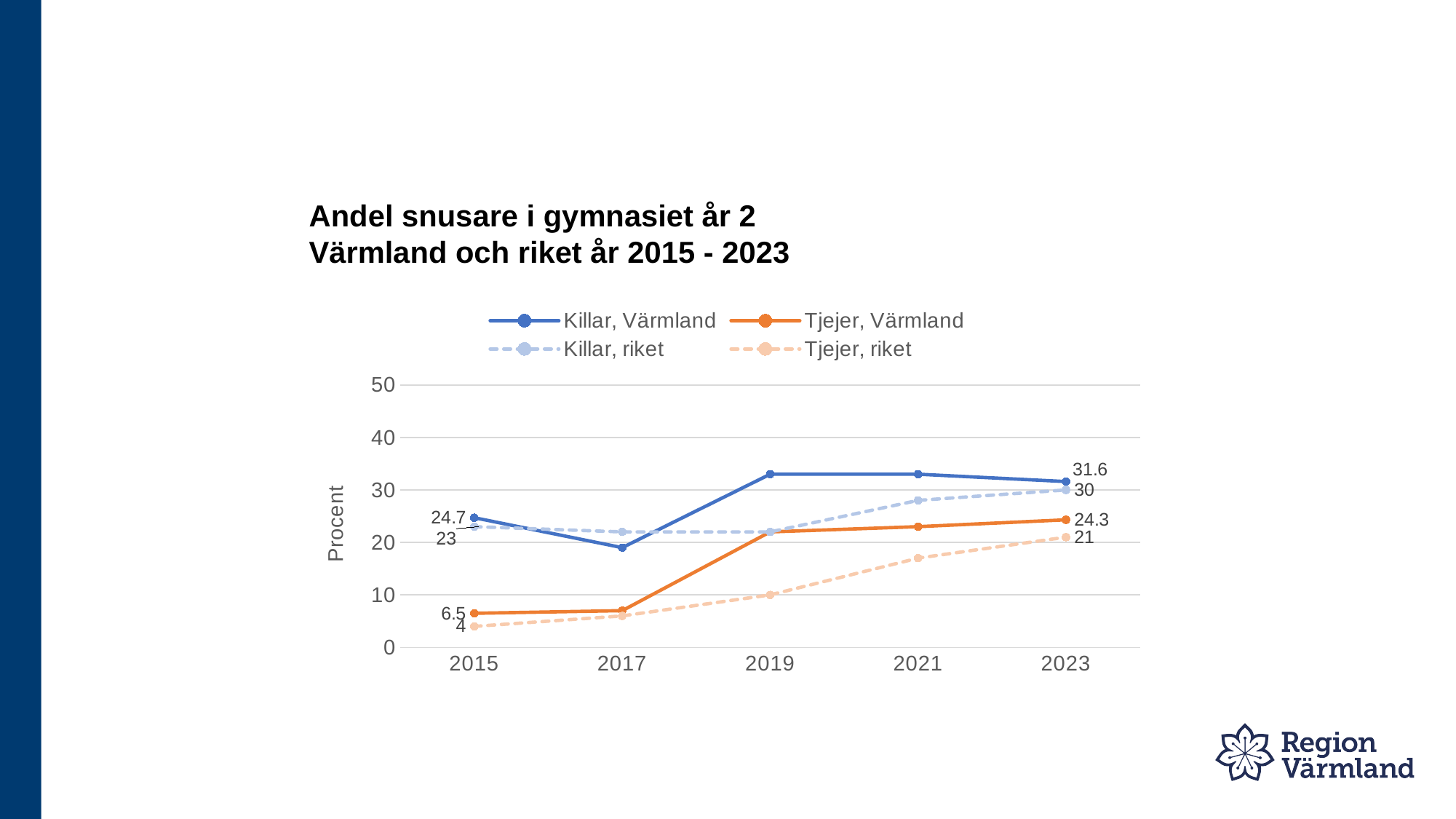
What is the value for Tjejer, riket in 2023? 21 What is the value for Killar, riket in 2015? 23 What is the difference between Killar, Värmland and Killar, riket in 2023? 1.6 What is the value for Tjejer, Värmland in 2015? 6.5 Which series has the lowest value in 2015? Tjejer, riket How many series does the legend list? 4 By how much did Tjejer, Värmland increase from 2015 to 2023? 17.8 Does Tjejer, riket rise or fall from 2015 to 2023? Rise What is the value for Killar, Värmland in 2023? 31.6 Is the value for Killar, Värmland in 2019 greater or less than 30? greater What type of chart is shown on the slide? Line chart How many years are shown on the x axis? 5